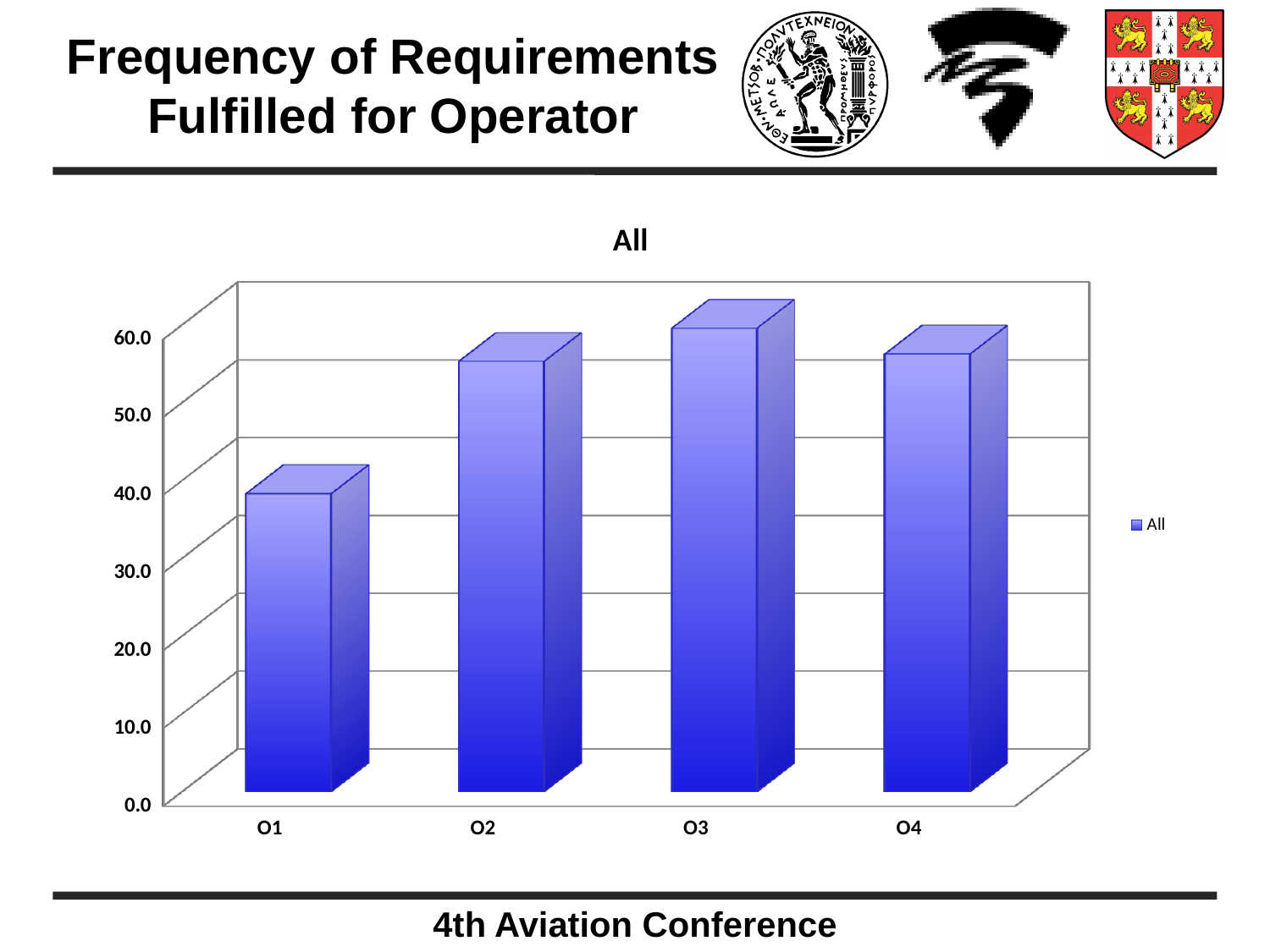
Which is larger, the value for O1 or the value for O3? O3 What kind of chart is shown on the slide? bar chart Is the value for O2 greater or less than 40? greater How many series does the chart legend list? 1 Is the value for O1 greater or less than 50? less Which operator has the highest value in the chart? O3 Does the value rise or fall from O1 to O2? rise How many operator categories are shown on the x axis of the chart? 4 Is the value for O3 greater or less than 50? greater Which operator has the lowest value in the chart? O1 What is the title of the chart? All